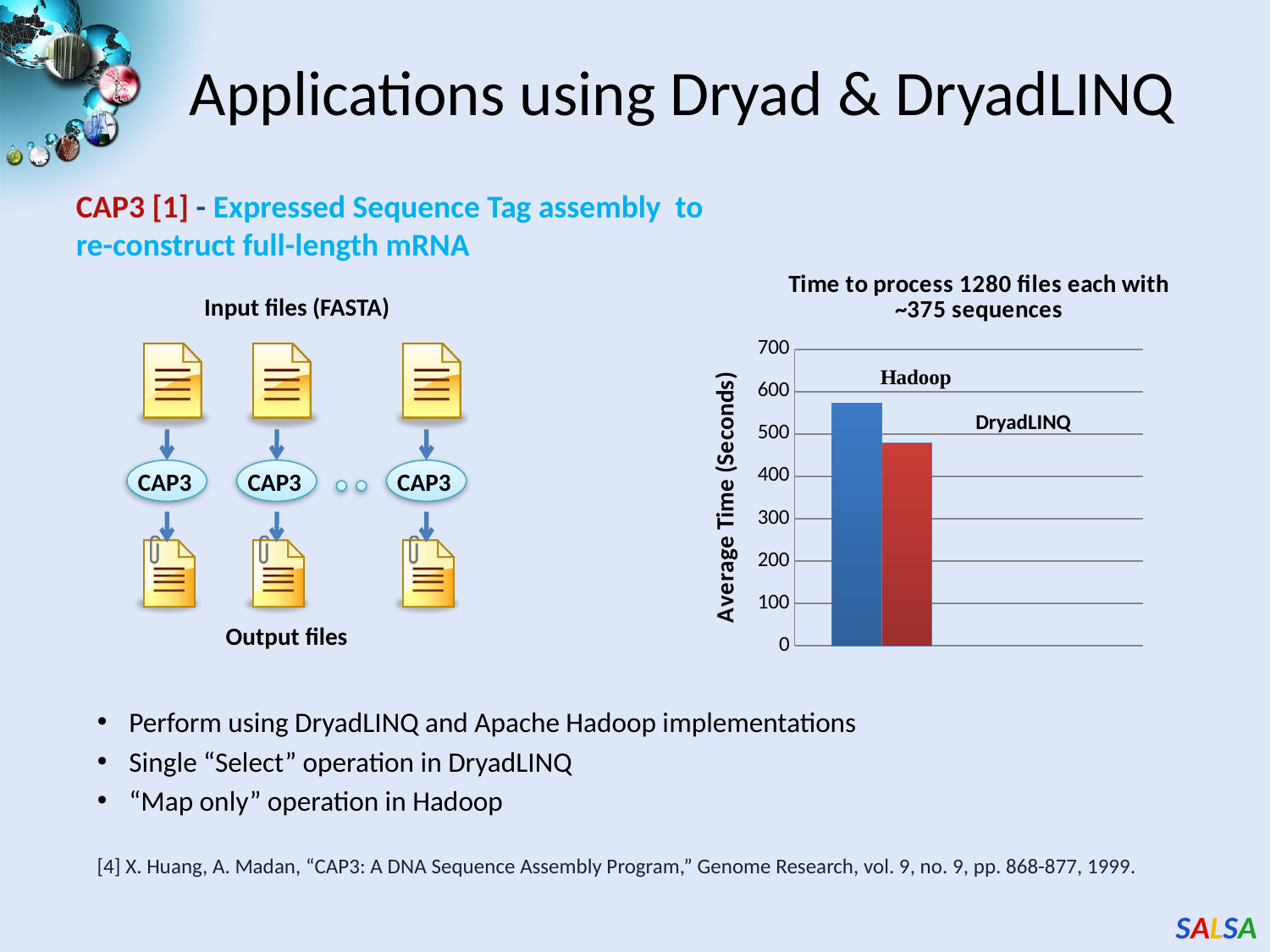
Which has a larger average time, Hadoop or DryadLINQ? Hadoop What is the label of the vertical axis of the chart? Average Time (Seconds) Is the value for DryadLINQ greater or less than 400? greater Is the value for Hadoop greater or less than 500? greater Is the value for DryadLINQ greater or less than 500? less Which implementation has the highest average time in the chart? Hadoop What is the title of the chart? Time to process 1280 files each with ~375 sequences How many bars are plotted in the chart? 2 Which implementation has the lowest average time in the chart? DryadLINQ What kind of chart is shown on the slide? bar chart